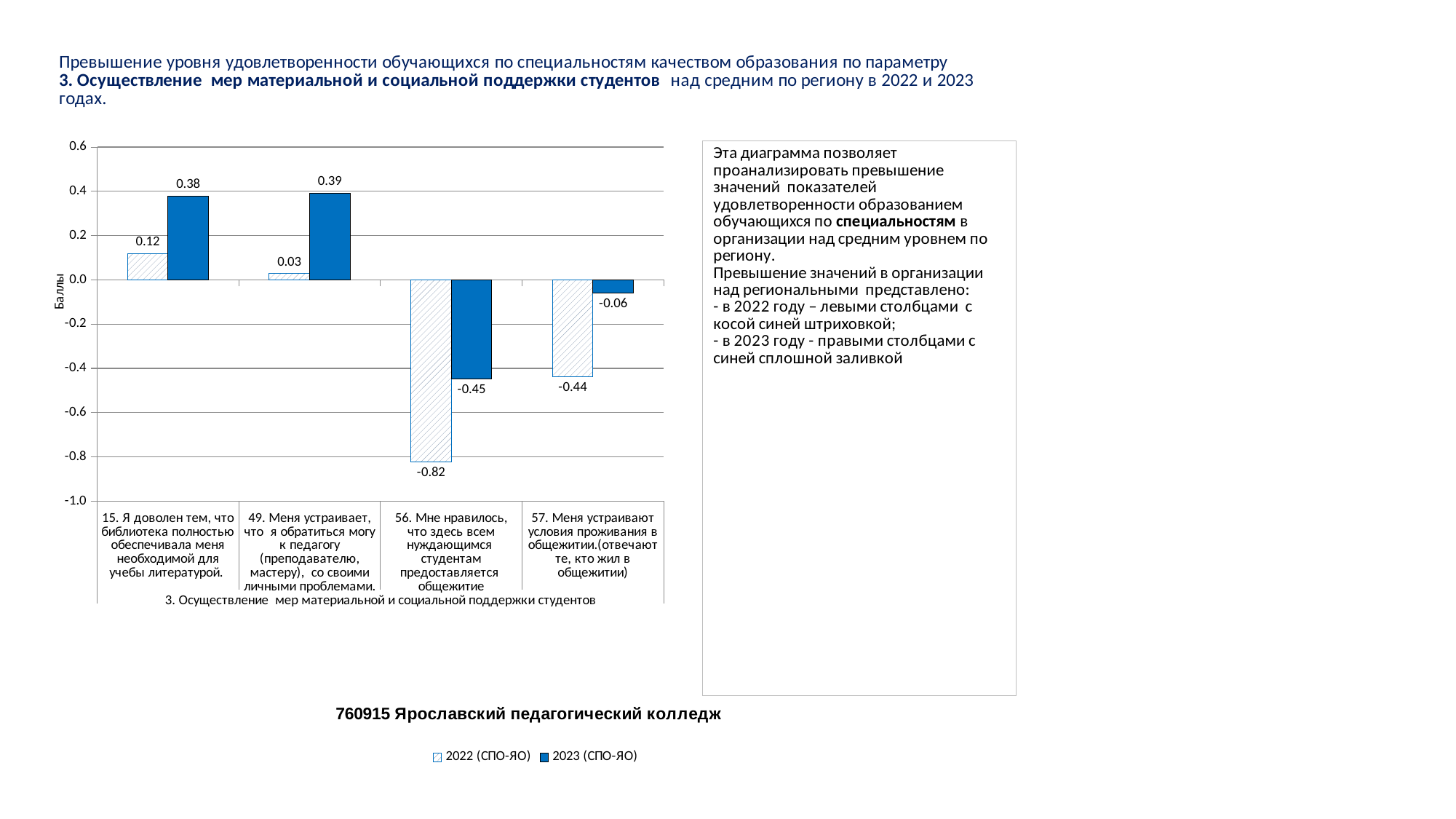
What type of chart is shown on the slide? Bar chart What is the 2022 (СПО-ЯО) value for category 56 (dormitory provided to all students in need)? -0.82 What is the 2023 (СПО-ЯО) value for category 49 (can approach a teacher with personal problems)? 0.39 What is the difference between the 2023 and 2022 values for category 56? 0.37 Which is larger for category 57: the 2022 value or the 2023 value? 2023 (СПО-ЯО) How many series does the legend list? 2 Which category has the lowest 2022 (СПО-ЯО) value? 56. Мне нравилось, что здесь всем нуждающимся студентам предоставляется общежитие How many categories are shown on the x axis? 4 What is the 2023 (СПО-ЯО) value for category 57 (satisfied with dormitory living conditions)? -0.06 What is the difference between the 2023 and 2022 values for category 15? 0.26 What is the 2022 (СПО-ЯО) value for category 15 (library provided necessary literature)? 0.12 Which category has the highest 2023 (СПО-ЯО) value? 49. Меня устраивает, что я обратиться могу к педагогу (преподавателю, мастеру), со своими личными проблемами.